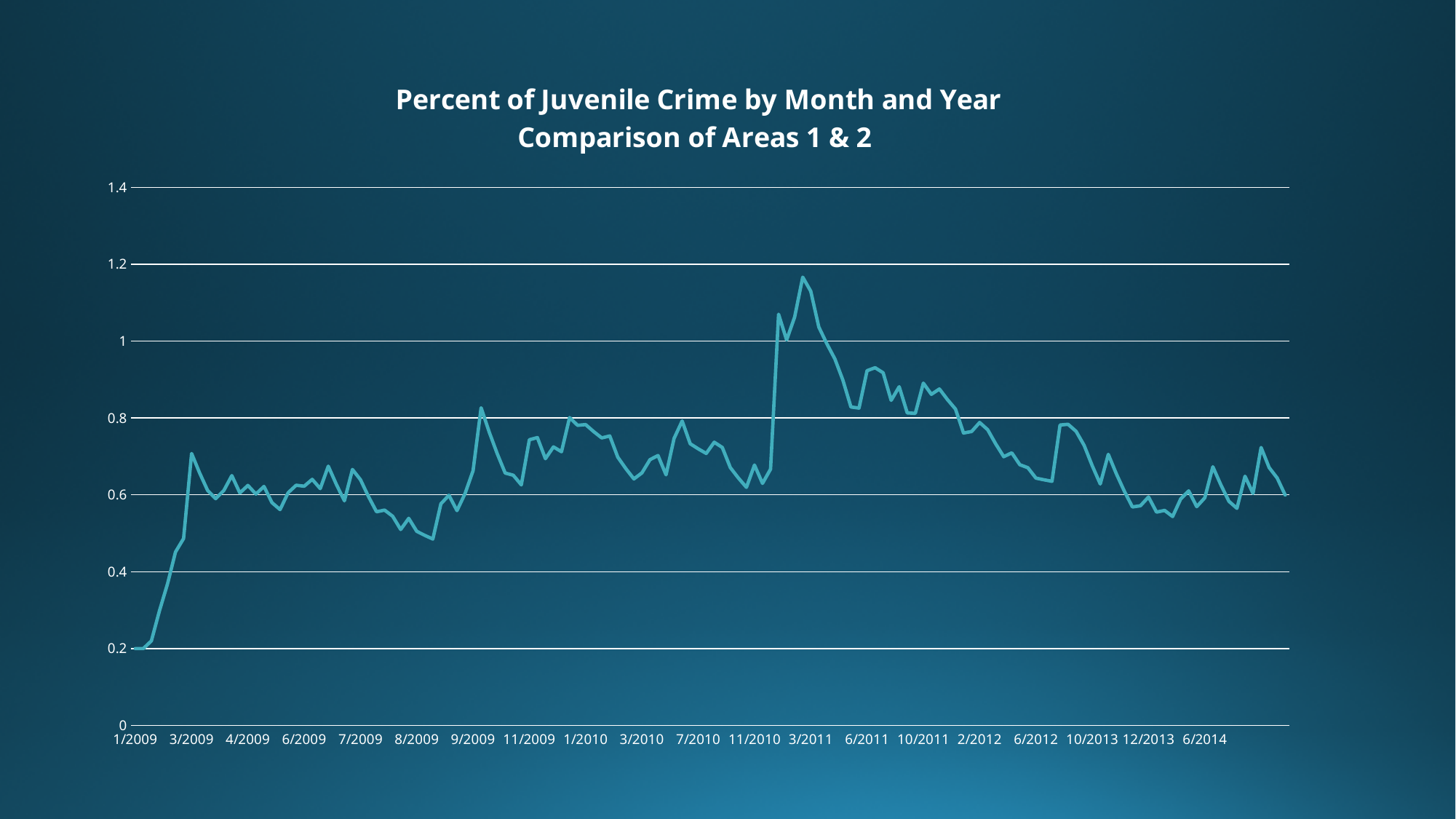
Is the value at 2/2012 greater or less than 0.6? greater Is the value at 3/2009 greater or less than 0.6? greater Is the value at 8/2009 greater or less than 0.6? less What is the title of the chart? Percent of Juvenile Crime by Month and Year Comparison of Areas 1 & 2 What kind of chart is shown on the slide? Line chart What is the highest value shown on the vertical axis? 1.4 Near which labelled date on the x axis does the line reach its highest value? 3/2011 How many date labels are shown along the x axis? 20 Does the line rise or fall between 1/2009 and 3/2009? Rise